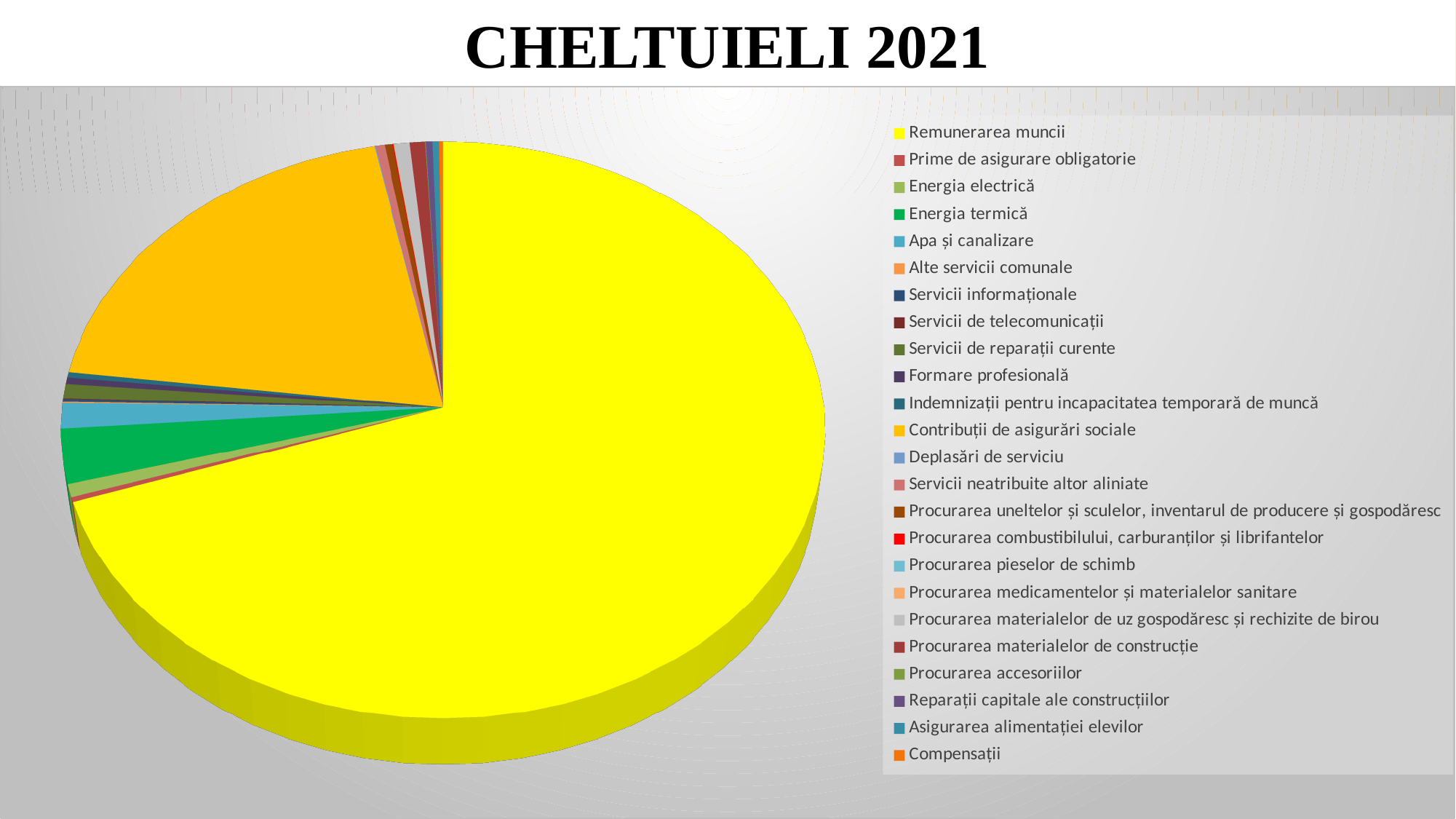
Which is larger, the slice for Energia termică or the slice for Energia electrică? Energia termică What kind of chart is shown on the slide? Pie chart Does the slice for Remunerarea muncii cover more or less than half of the pie? More What colour is the slice for Remunerarea muncii? Yellow Which category has the second-largest slice of the pie? Contribuții de asigurări sociale Which is larger, the slice for Contribuții de asigurări sociale or the slice for Energia termică? Contribuții de asigurări sociale What is the title of the chart? CHELTUIELI 2021 Which category has the largest slice of the pie? Remunerarea muncii Which is larger, the slice for Remunerarea muncii or the slice for Contribuții de asigurări sociale? Remunerarea muncii How many categories does the legend list? 24